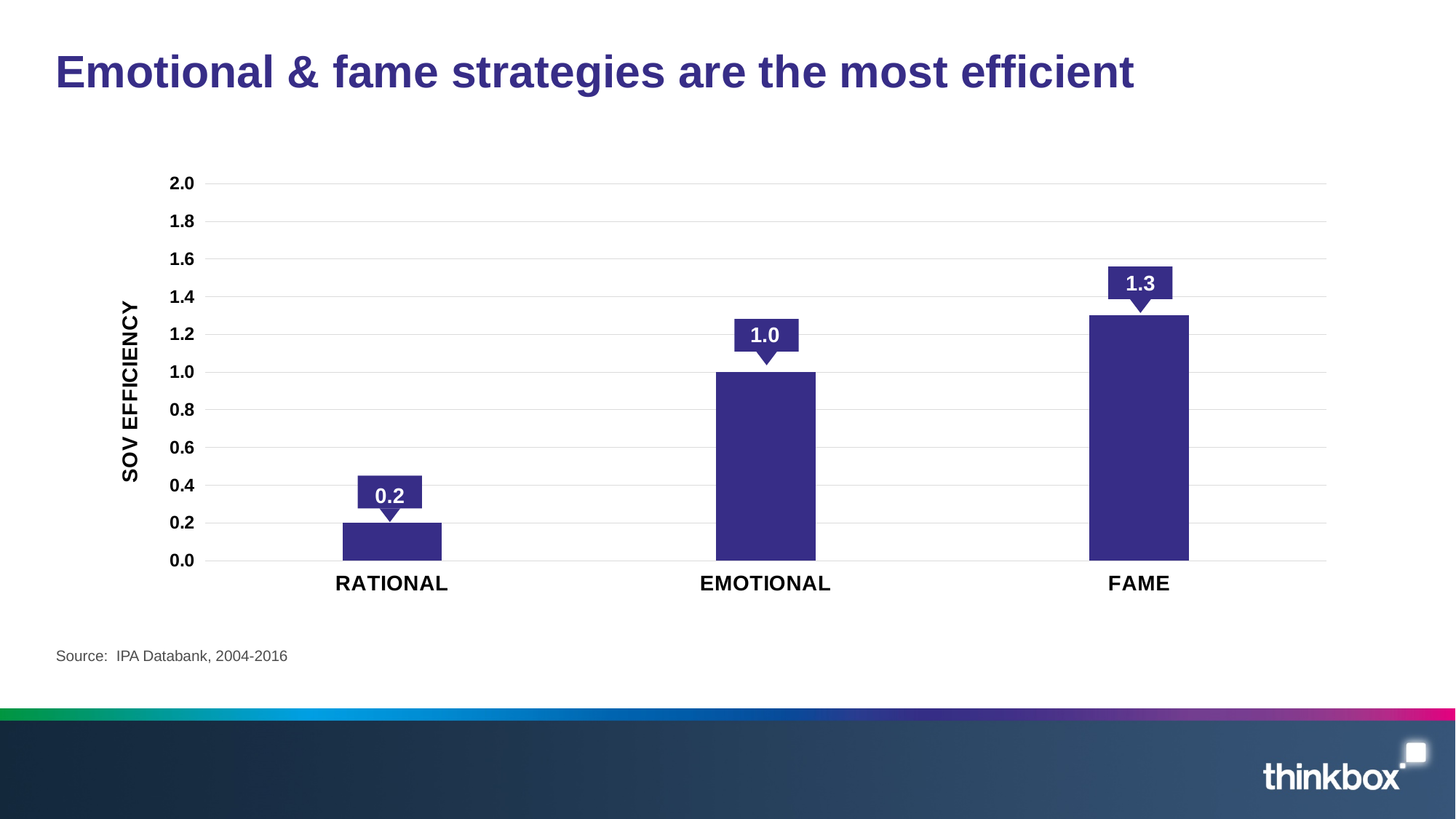
What is the label of the y axis? SOV EFFICIENCY Is the SOV efficiency for FAME greater or less than 1.2? greater Which has a higher SOV efficiency, EMOTIONAL or FAME? FAME What is the difference in SOV efficiency between EMOTIONAL and RATIONAL? 0.8 What is the SOV efficiency value for FAME? 1.3 What kind of chart is shown on the slide? Bar chart Which category has the highest SOV efficiency? FAME How many categories are shown on the x axis? 3 Which category has the lowest SOV efficiency? RATIONAL What is the difference in SOV efficiency between FAME and RATIONAL? 1.1 What is the SOV efficiency value for EMOTIONAL? 1.0 What is the SOV efficiency value for RATIONAL? 0.2